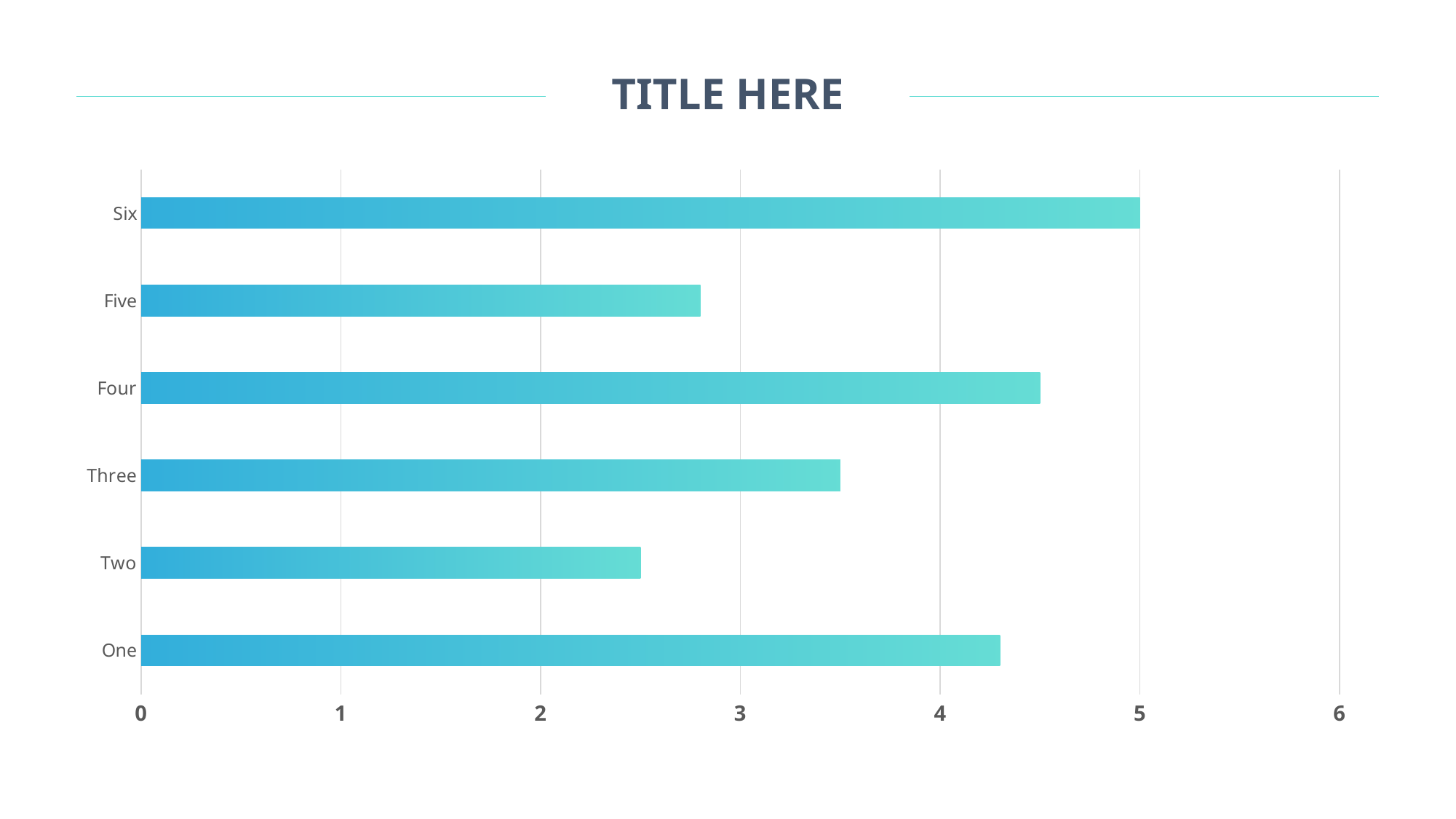
Which category has the highest value? Six Is the value for One greater or less than 4? greater Which is larger, the value for Four or the value for One? Four Which category has the lowest value? Two Is the value for Five greater or less than 3? less Is the value for Three greater or less than 3? greater What is the value for Six? 5 What kind of chart is shown on the slide? bar chart Which is larger, the value for Three or the value for Five? Three How many categories are shown in the chart? 6